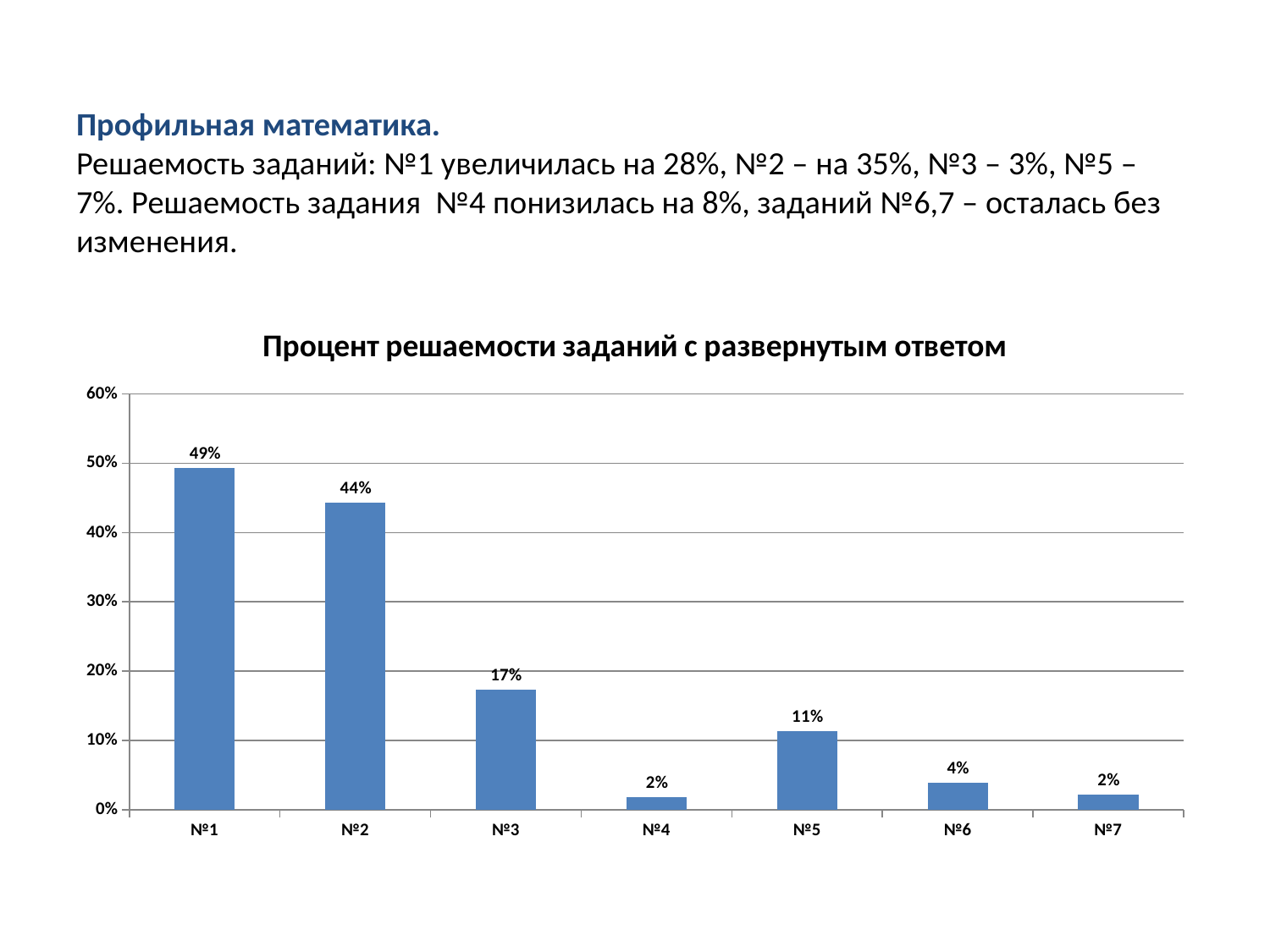
Is the value for №2 greater or less than 40%? greater What is the value for №6? 4% What is the value for №1? 49% What is the difference between the values for №1 and №2? 5% Which category has the highest value? №1 What kind of chart is this? bar chart What is the difference between the values for №3 and №5? 6% Which is larger, the value for №3 or the value for №5? №3 How many categories are shown on the x axis? 7 What is the title of the chart? Процент решаемости заданий с развернутым ответом Do the values rise or fall from №1 to №4? fall What is the value for №5? 11%